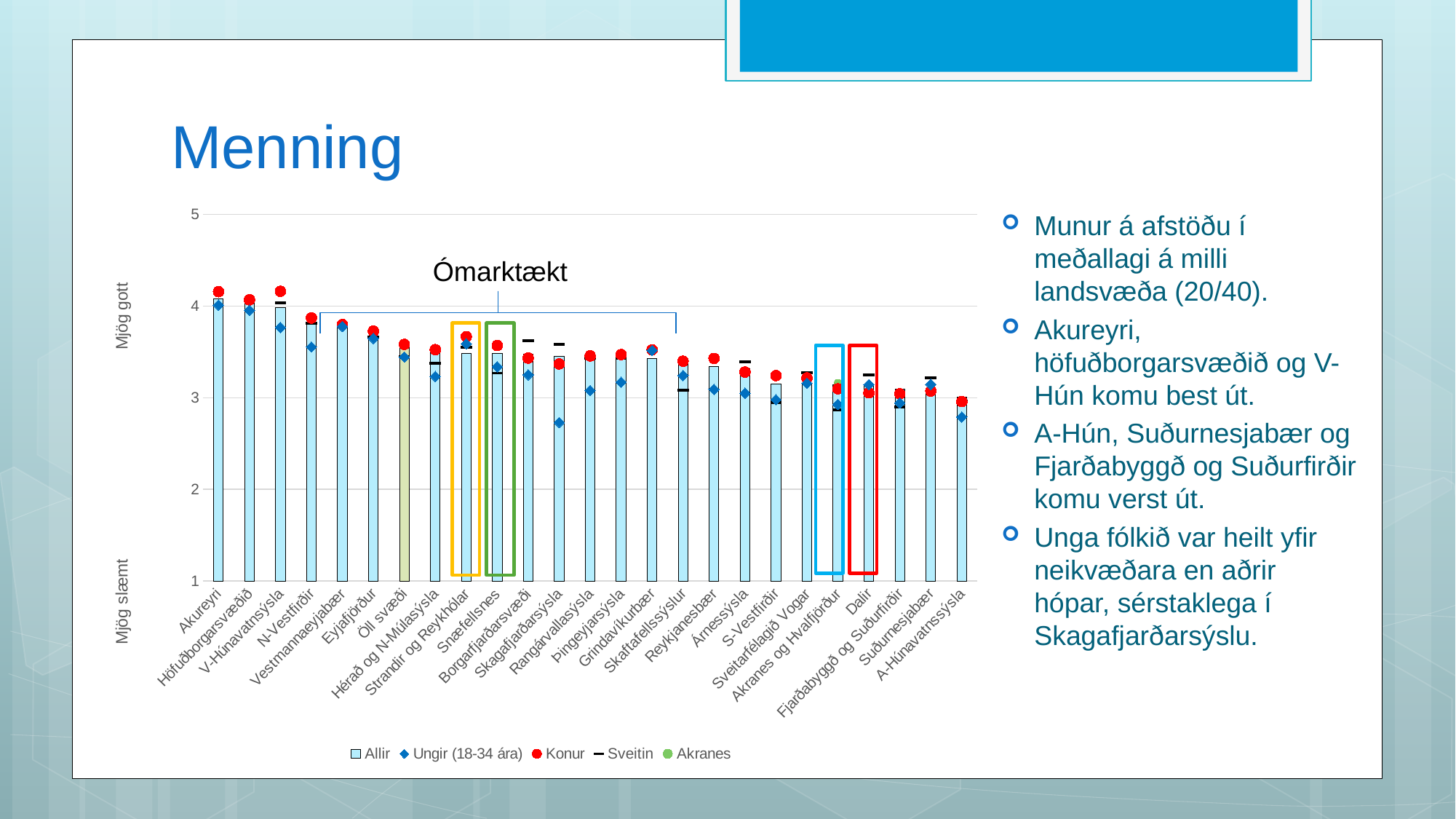
Which has the larger Allir value, Akureyri or A-Húnavatnssýsla? Akureyri Is the Konur value for Akureyri greater or less than 4? greater Is the Allir value for Rangárvallasýsla greater or less than 4? less Do the Allir bar values generally rise or fall from left to right along the x axis? Fall Which series are listed in the chart's legend? Allir, Ungir (18-34 ára), Konur, Sveitin, Akranes How many categories (regions) are shown along the x axis of the chart? 25 How many series does the chart's legend list? 5 Which has the larger Ungir (18-34 ára) value, Skagafjarðarsýsla or Rangárvallasýsla? Rangárvallasýsla Is the Ungir (18-34 ára) value for Skagafjarðarsýsla greater or less than 3? less What kind of chart is shown on the slide? Bar chart What annotation text is written above the middle of the chart? Ómarktækt